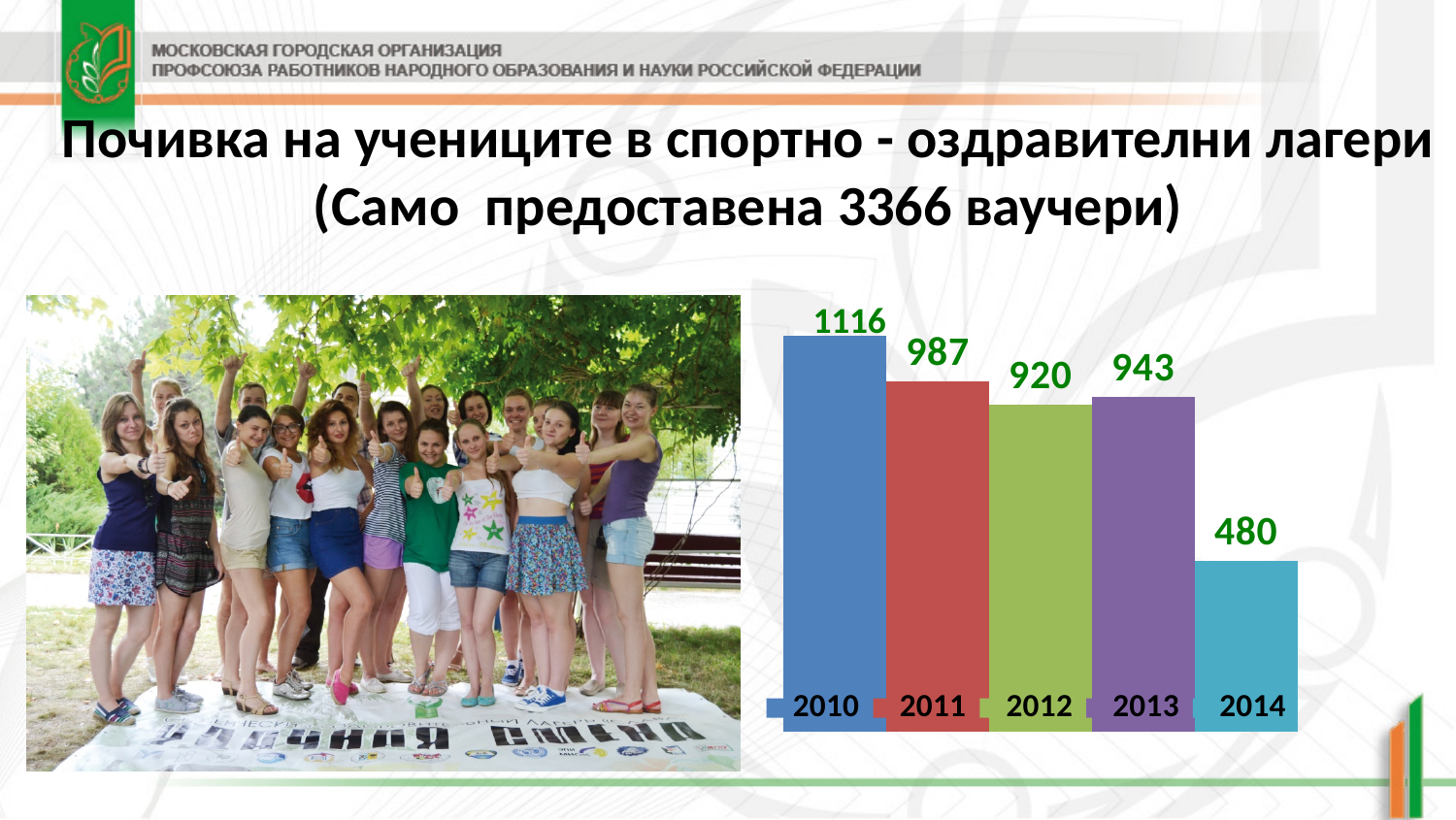
Which is larger, the value for 2013 or the value for 2012? 2013 What is the value for 2010? 1116 Which year has the lowest value? 2014 How many years are shown in the chart? 5 What is the value for 2014? 480 What colour is the bar for 2011? red Which year has the highest value? 2010 What is the difference between the values for 2010 and 2014? 636 What kind of chart is shown on the slide? bar chart What is the difference between the values for 2011 and 2012? 67 Do the values rise or fall from 2013 to 2014? fall What is the value for 2012? 920